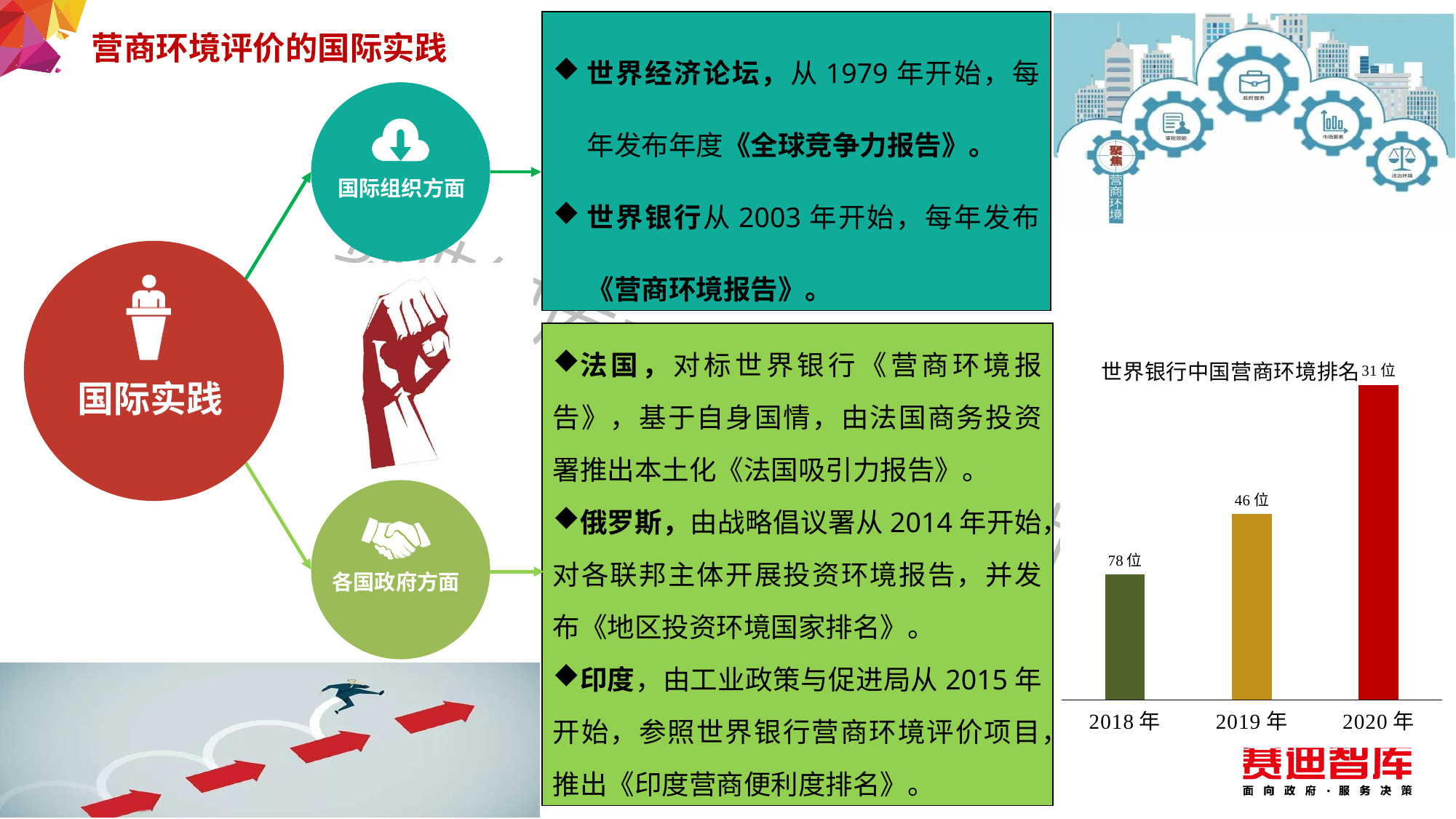
In the 世界银行中国营商环境排名 chart, what is the difference between the 2018年 value and the 2020年 value? 47 位 In the 世界银行中国营商环境排名 chart, which is the larger number, the value for 2018年 or the value for 2019年? 2018 年 In the 世界银行中国营商环境排名 chart, what is the difference between the 2019年 value and the 2020年 value? 15 位 What is the value shown for 2018年 in the 世界银行中国营商环境排名 chart? 78 位 In the 世界银行中国营商环境排名 chart, which year has the smallest numerical value? 2020 年 What is the value shown for 2020年 in the 世界银行中国营商环境排名 chart? 31 位 In the 世界银行中国营商环境排名 chart, do the labelled values rise or fall from 2018年 to 2020年? Fall How many years are shown in the 世界银行中国营商环境排名 chart? 3 What is the value shown for 2019年 in the 世界银行中国营商环境排名 chart? 46 位 What is the title of the chart on the right side of the slide? 世界银行中国营商环境排名 What kind of chart is the 世界银行中国营商环境排名 chart? Bar chart In the 世界银行中国营商环境排名 chart, which year has the largest numerical value? 2018 年